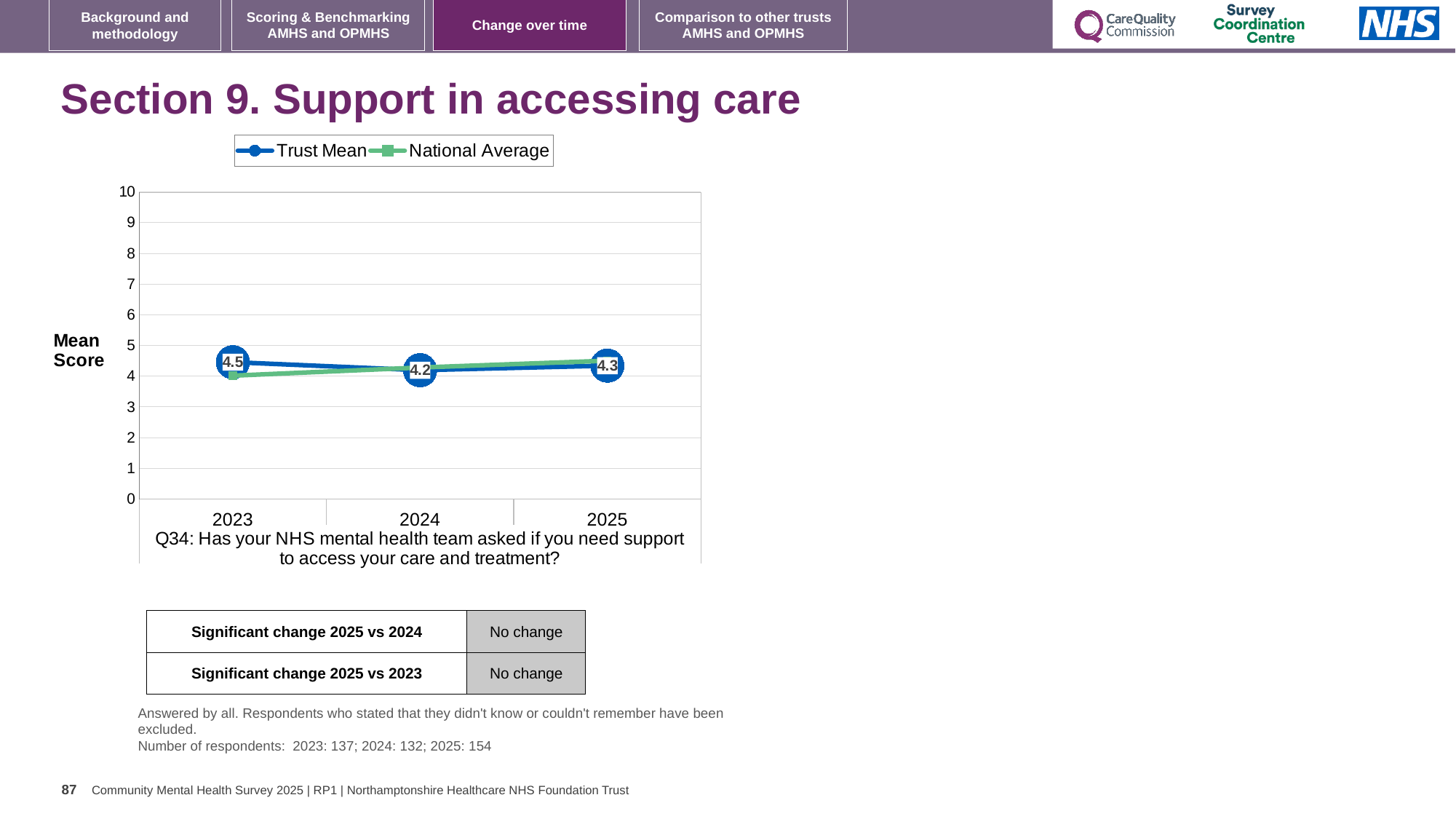
Does the Trust Mean score rise or fall from 2023 to 2024? Fall Is the National Average value for 2023 greater or less than 5? less What is the Trust Mean score for 2025? 4.3 What is the Trust Mean score for 2024? 4.2 How many years are plotted on the x axis? 3 What is the difference between the Trust Mean scores for 2023 and 2024? 0.3 In which year is the Trust Mean score highest? 2023 What kind of chart is shown on the slide? Line chart In which year is the Trust Mean score lowest? 2024 Which year has the larger Trust Mean score, 2023 or 2025? 2023 How many series does the legend list? 2 What is the Trust Mean score for 2023? 4.5